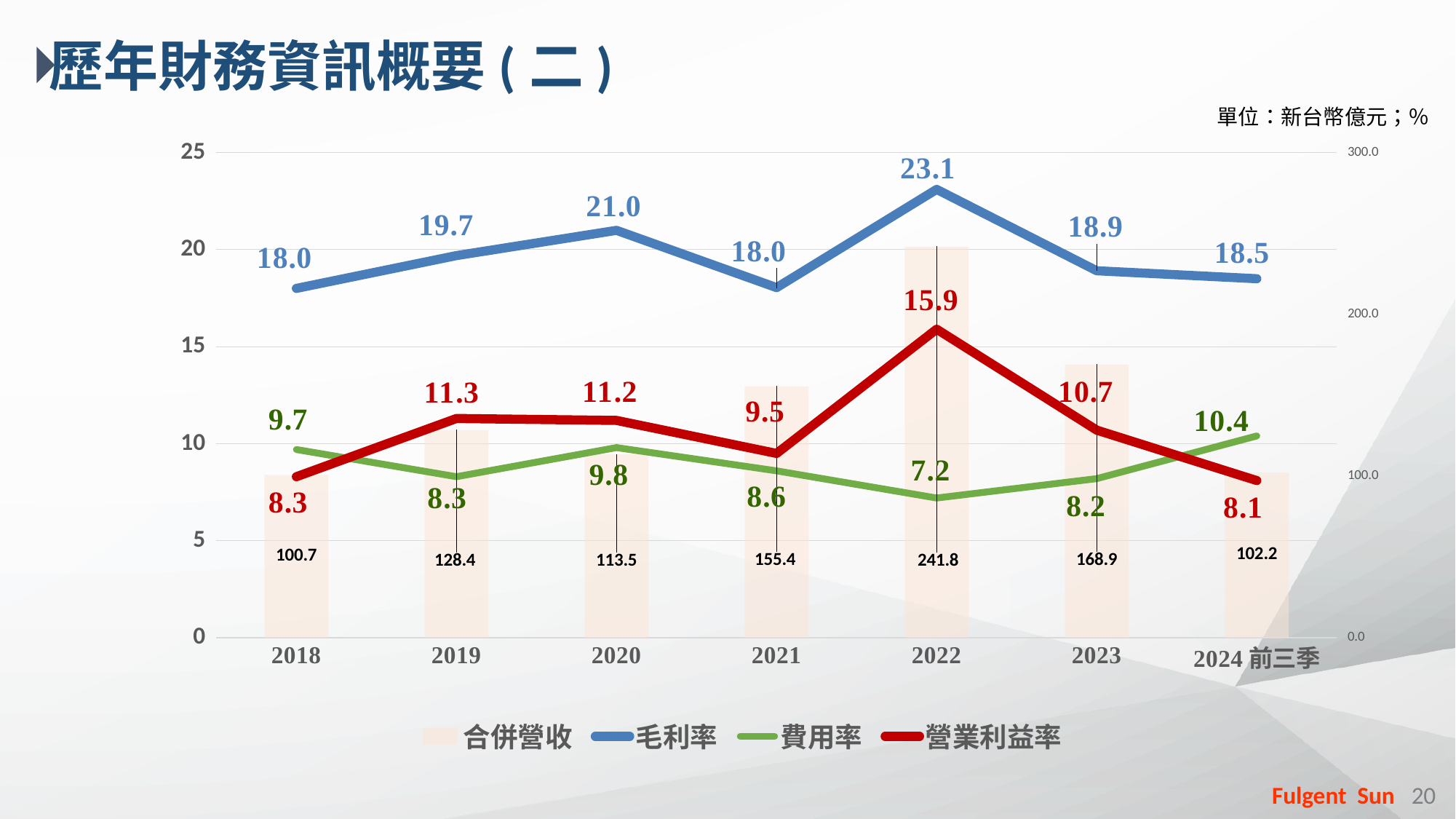
Does 合併營收 rise or fall from 2022 to 2024 前三季? fall In which year is 合併營收 highest? 2022 Which series is drawn in red? 營業利益率 In which year is 費用率 lowest? 2022 What is the difference between the 毛利率 values for 2022 and 2021? 5.1 What is the 費用率 value for 2021? 8.6 What is the 營業利益率 value for 2024 前三季? 8.1 How many categories are shown on the x axis? 7 Which is larger, the 營業利益率 for 2019 or for 2020? 2019 What is the 毛利率 value for 2020? 21.0 What is the 合併營收 value for 2022? 241.8 How many series does the legend list? 4